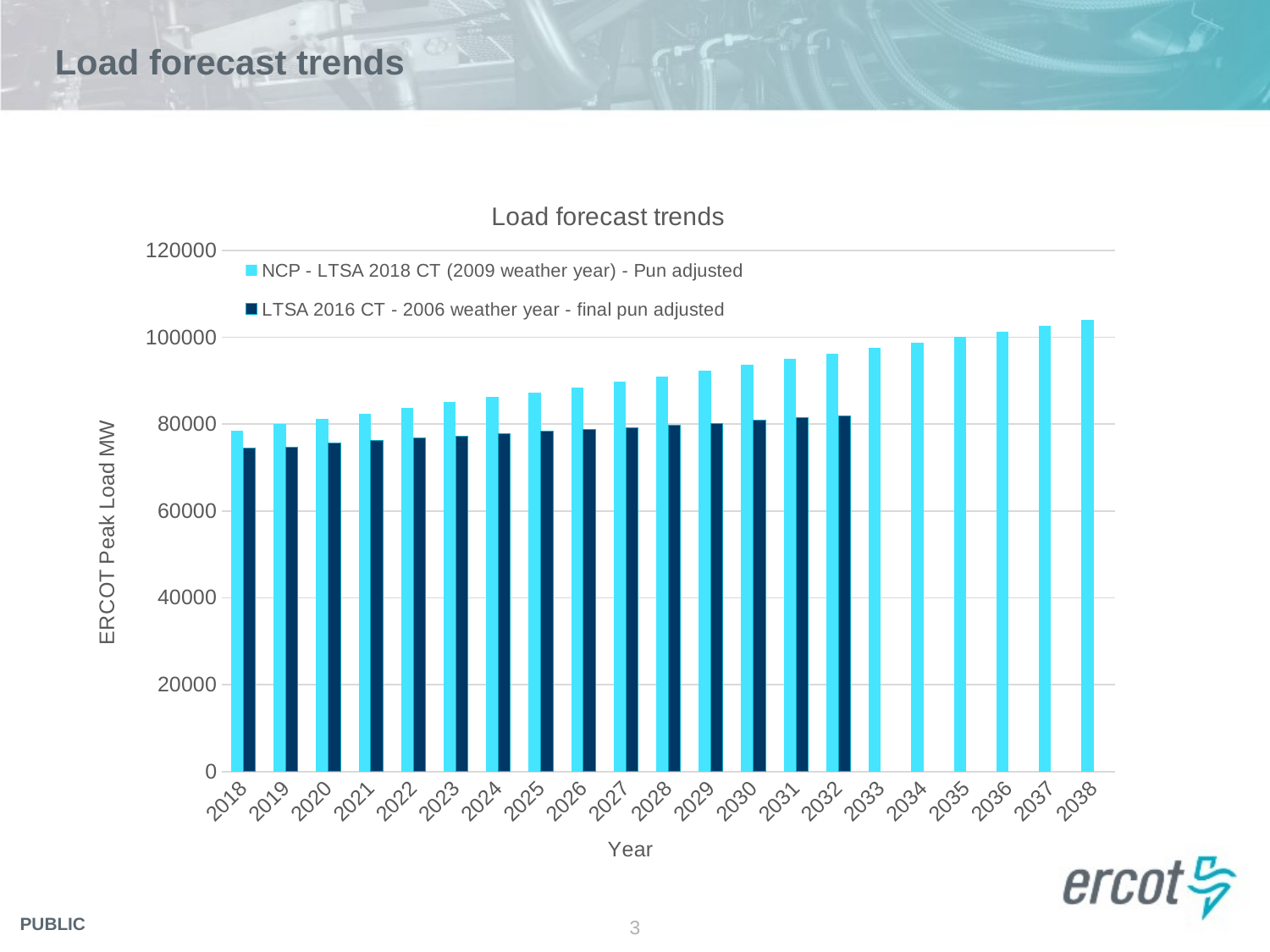
Do the values for the NCP - LTSA 2018 CT (2009 weather year) - Pun adjusted series rise or fall from 2018 to 2038? rise What is the title of the vertical axis? ERCOT Peak Load MW Is the value for 2018 in the LTSA 2016 CT - 2006 weather year - final pun adjusted series greater or less than 80000? less Which year has the highest value for the LTSA 2016 CT - 2006 weather year - final pun adjusted series? 2032 Which year has the lowest value for the NCP - LTSA 2018 CT (2009 weather year) - Pun adjusted series? 2018 For 2025, which series has the larger value: NCP - LTSA 2018 CT (2009 weather year) - Pun adjusted or LTSA 2016 CT - 2006 weather year - final pun adjusted? NCP - LTSA 2018 CT (2009 weather year) - Pun adjusted How many series does the legend list? 2 Is the value for 2030 in the NCP - LTSA 2018 CT (2009 weather year) - Pun adjusted series greater or less than 80000? greater How many years are shown on the x axis? 21 What kind of chart is shown on the slide? bar chart Which year has the highest value for the NCP - LTSA 2018 CT (2009 weather year) - Pun adjusted series? 2038 Is the value for 2038 in the NCP - LTSA 2018 CT (2009 weather year) - Pun adjusted series greater or less than 100000? greater